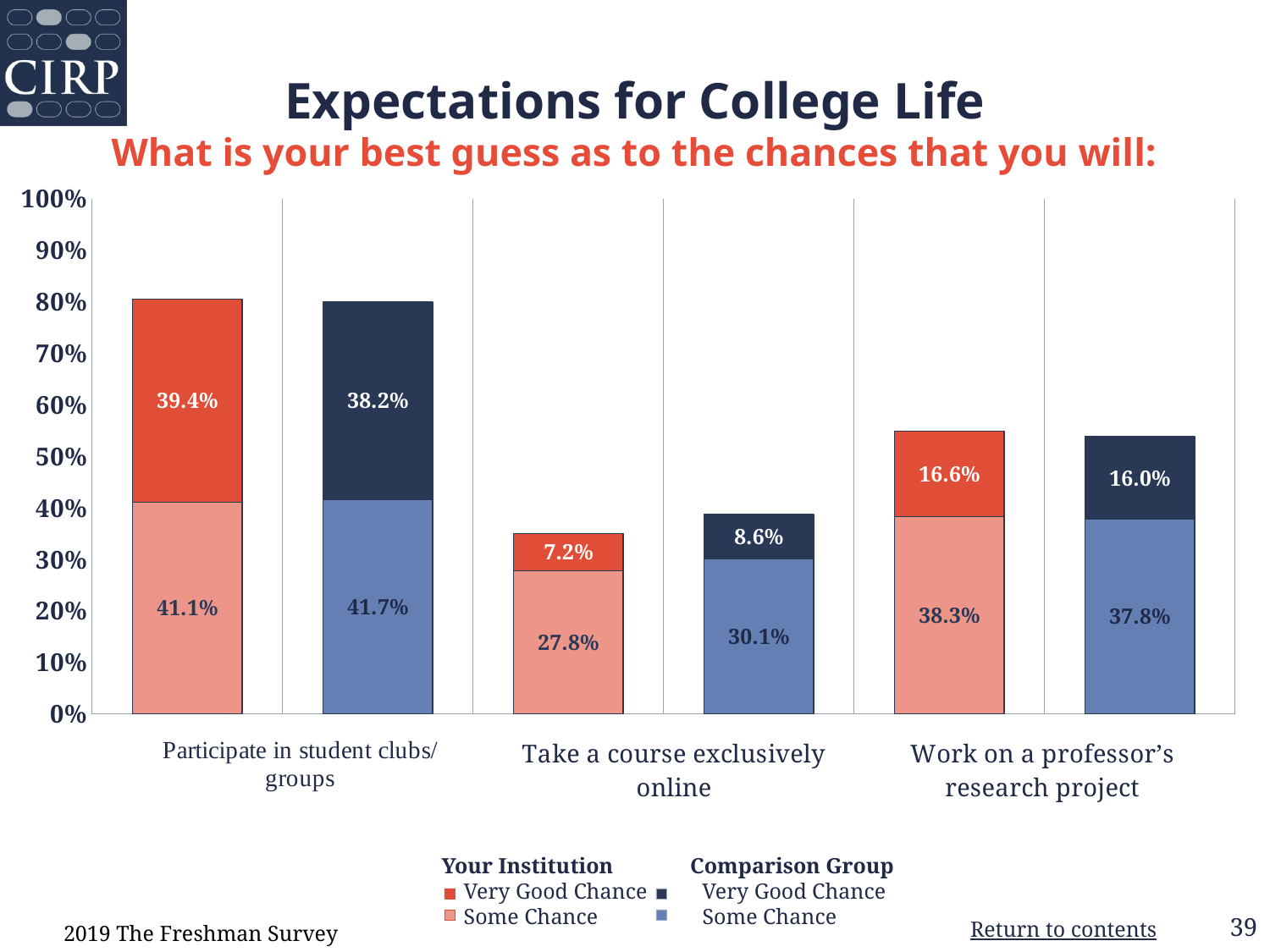
What is the Your Institution 'Some Chance' value for 'Work on a professor's research project'? 38.3% Which category has the lowest Your Institution 'Very Good Chance' value? Take a course exclusively online What is the Your Institution 'Very Good Chance' value for 'Participate in student clubs/groups'? 39.4% What is the total of the Comparison Group stacked bar for 'Work on a professor's research project'? 53.8% How many series does the legend list? 4 Which is larger for 'Take a course exclusively online': the Your Institution 'Some Chance' value or the Comparison Group 'Some Chance' value? Comparison Group What is the difference between the Comparison Group and Your Institution 'Very Good Chance' values for 'Take a course exclusively online'? 1.4% What is the Comparison Group 'Some Chance' value for 'Take a course exclusively online'? 30.1% Which category has the highest Comparison Group 'Some Chance' value? Participate in student clubs/groups What is the Comparison Group 'Very Good Chance' value for 'Work on a professor's research project'? 16.0% What kind of chart is shown on the slide? Stacked bar chart What is the total of the Your Institution stacked bar for 'Participate in student clubs/groups'? 80.5%